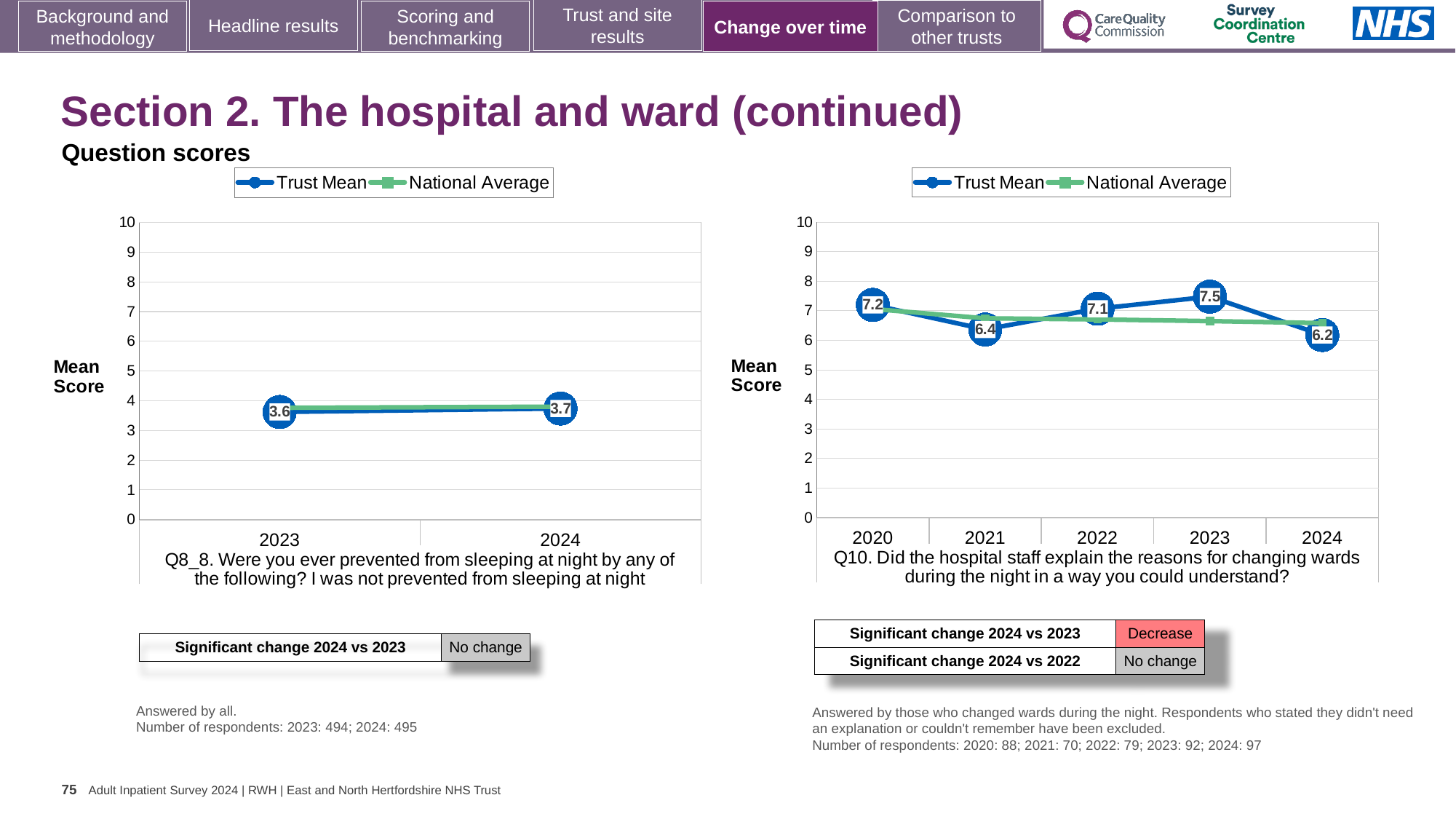
In the Q10 chart on the right, what is the difference between the Trust Mean for 2023 and the Trust Mean for 2024? 1.3 In the Q10 chart on the right, is the Trust Mean for 2020 or 2021 larger? 2020 In the Q10 chart on the right, is the Trust Mean for 2022 greater or less than 5? greater In the Q10 chart on the right, what is the Trust Mean for 2023? 7.5 In the Q8_8 chart on the left, what is the Trust Mean for 2023? 3.6 In the Q8_8 chart on the left, what is the Trust Mean for 2024? 3.7 What kind of chart is the Q10 chart on the right? Line chart How many years are shown on the x axis of the Q10 chart on the right? 5 In the Q10 chart on the right, which year has the highest Trust Mean? 2023 In the Q10 chart on the right, what is the Trust Mean for 2021? 6.4 In the Q10 chart on the right, which year has the lowest Trust Mean? 2024 How many series does the legend of the Q8_8 chart on the left list? 2